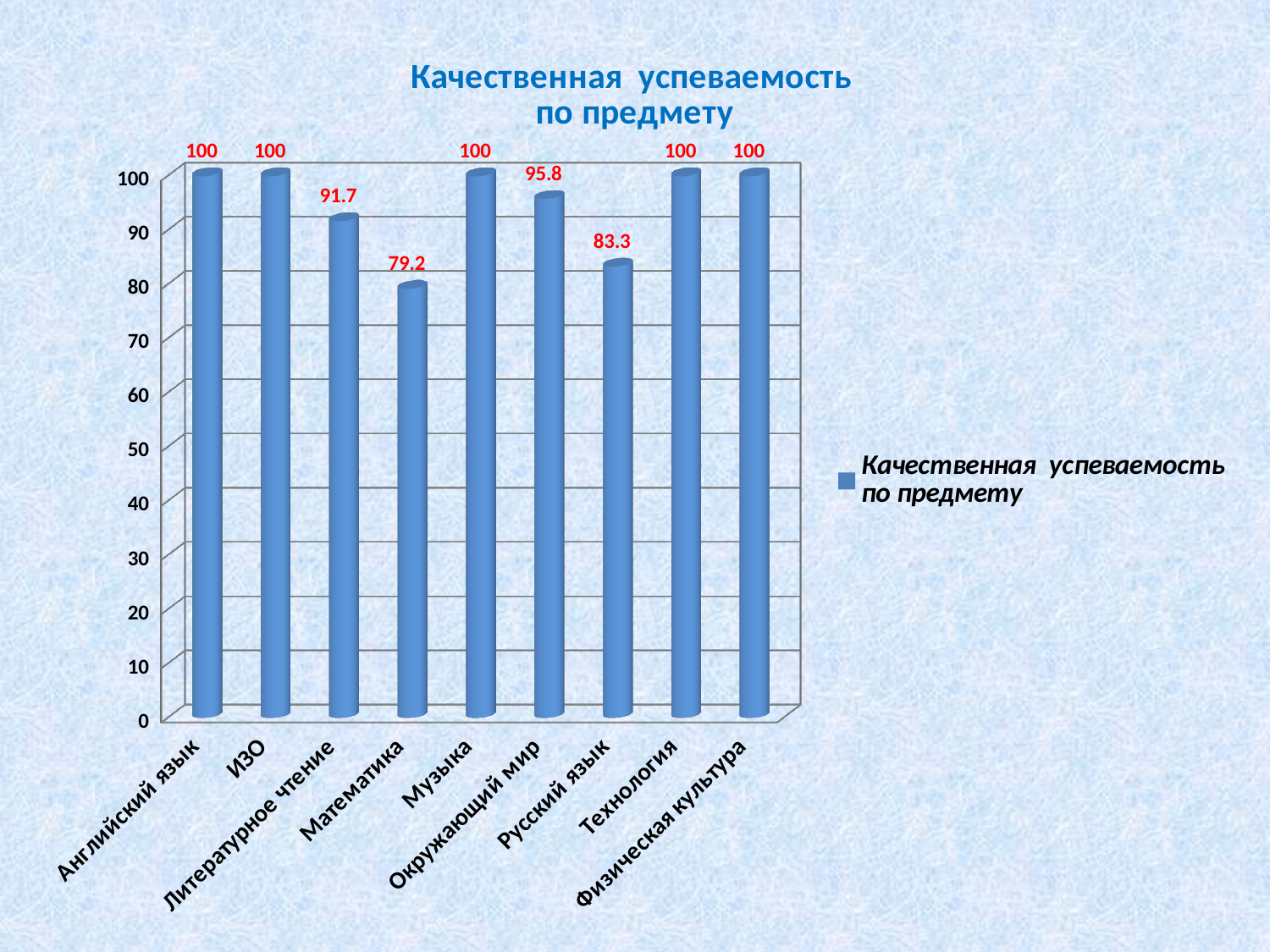
What is the difference between the values for Окружающий мир and Математика? 16.6 What kind of chart is shown on the slide? bar chart What is the value for Русский язык? 83.3 What is the value for Литературное чтение? 91.7 Is the value for Математика greater or less than 80? less What is the value for Окружающий мир? 95.8 Which is larger, the value for Литературное чтение or the value for Русский язык? Литературное чтение How many categories are shown on the x axis? 9 What is the value for Математика? 79.2 Which category has the lowest value? Математика What is the difference between the values for Литературное чтение and Русский язык? 8.4 How many categories have a value of 100? 5